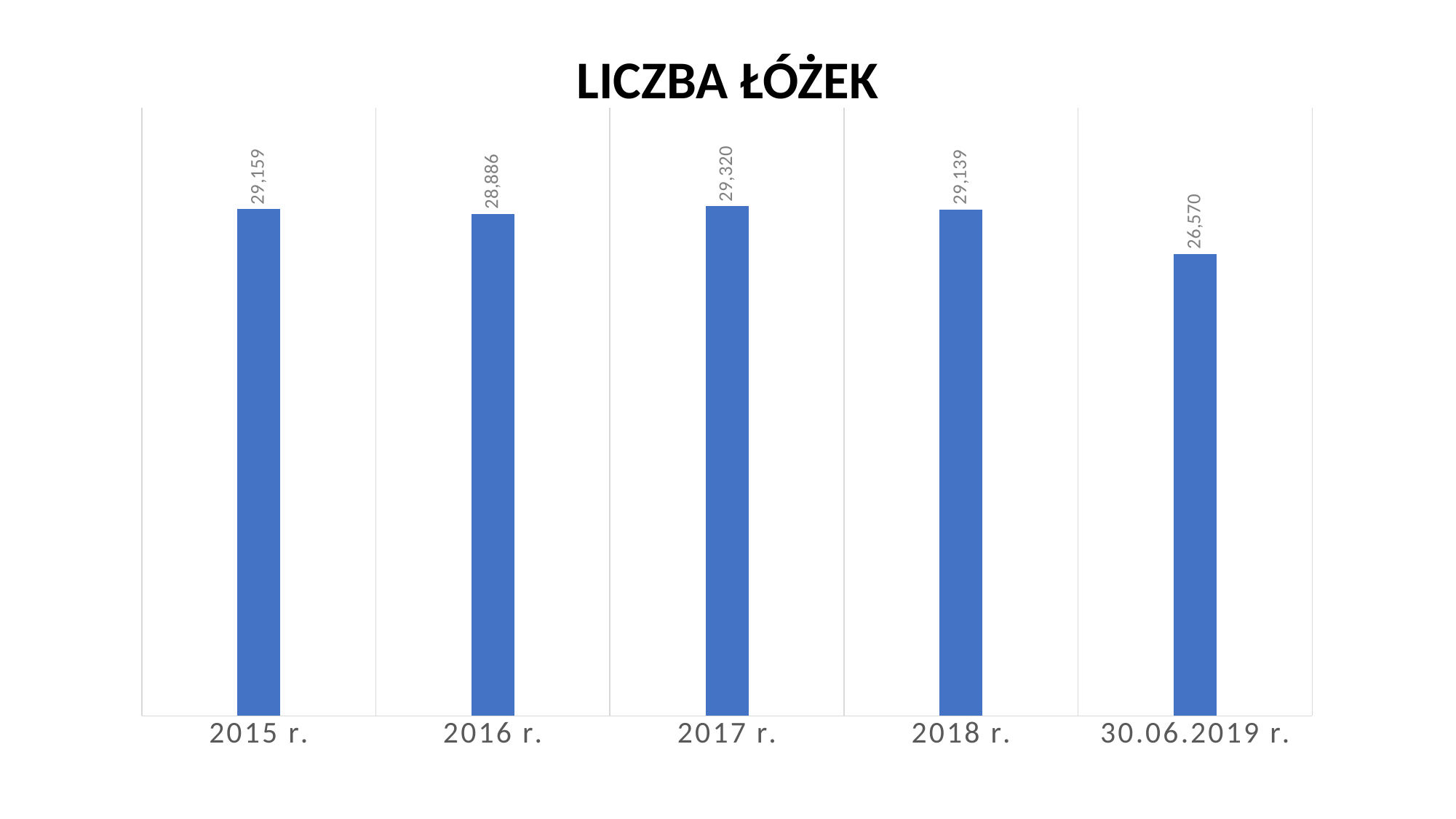
Which category has the highest value? 2017 r. Which category has the lowest value? 30.06.2019 r. What is the value for 30.06.2019 r.? 26,570 Which is larger, the value for 2015 r. or the value for 2016 r.? 2015 r. What is the title of the chart? LICZBA ŁÓŻEK What kind of chart is this? bar chart How many categories are shown on the x axis? 5 What is the value for 2016 r.? 28,886 What is the value for 2015 r.? 29,159 What is the value for 2017 r.? 29,320 What is the difference between the values for 2017 r. and 2016 r.? 434 What is the difference between the values for 2018 r. and 30.06.2019 r.? 2,569